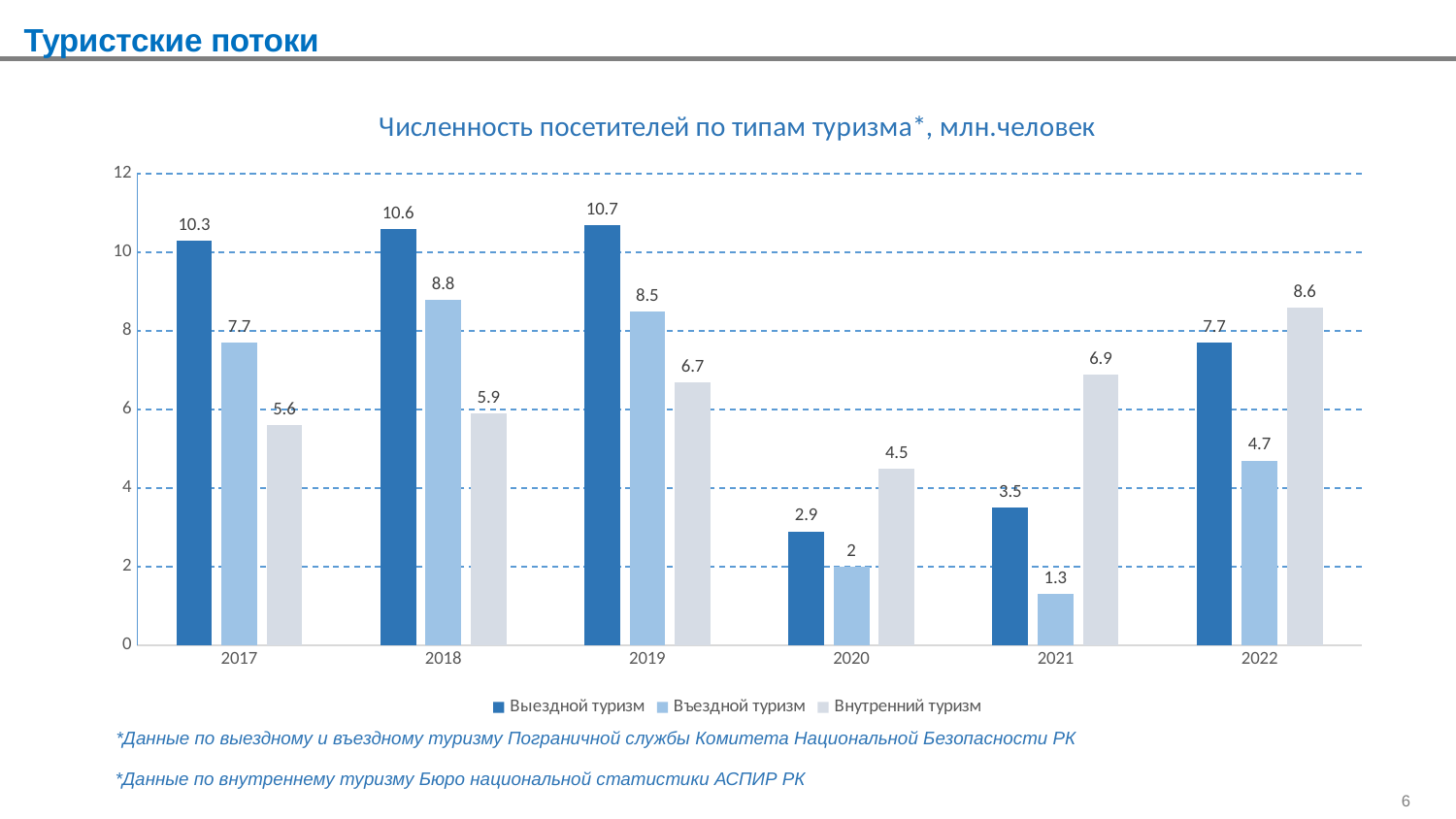
В каком году значение въездного туризма было наименьшим? 2021 Как менялось значение внутреннего туризма с 2020 по 2022 год — росло или падало? Росло Что больше в 2020 году: внутренний туризм или выездной туризм? Внутренний туризм На сколько значение выездного туризма в 2018 году больше значения въездного туризма в том же году? 1.8 Как называется диаграмма на слайде? Численность посетителей по типам туризма*, млн.человек Какое значение въездного туризма показано для 2021 года? 1.3 Сколько рядов данных перечислено в легенде? 3 Какой тип диаграммы показан на слайде? Столбчатая (bar chart) В каком году значение выездного туризма было наибольшим? 2019 Какое значение внутреннего туризма показано для 2022 года? 8.6 Сколько лет (категорий) показано на оси x? 6 Какое значение выездного туризма показано для 2019 года? 10.7